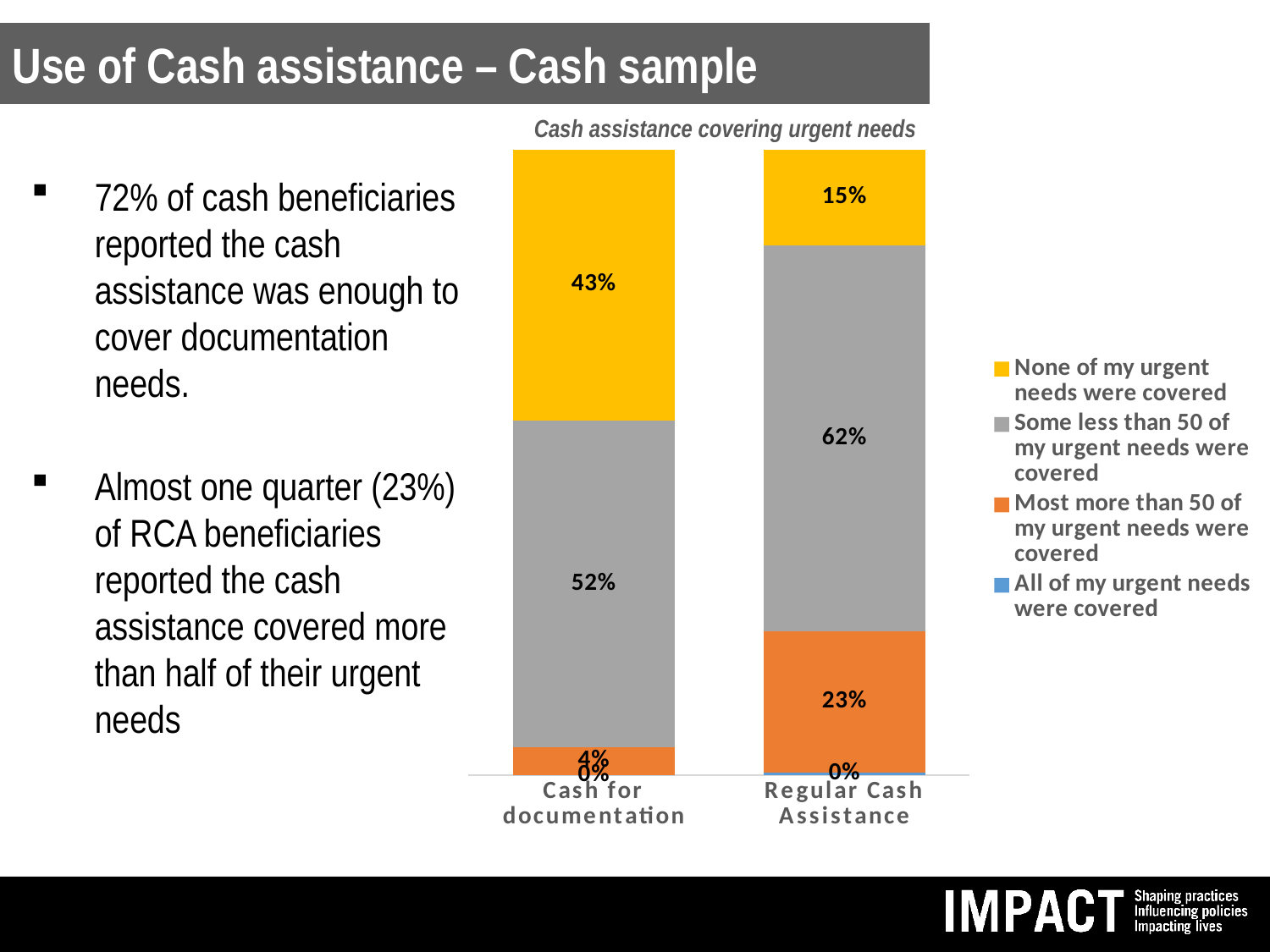
What percentage of Cash for documentation beneficiaries reported that none of their urgent needs were covered? 43% Which category has the larger share for 'None of my urgent needs were covered', Cash for documentation or Regular Cash Assistance? Cash for documentation How many categories are shown on the x axis? 2 What is the title of the chart? Cash assistance covering urgent needs What is the difference between the 'Some less than 50 of my urgent needs were covered' shares for Regular Cash Assistance and Cash for documentation? 10% Which colour represents 'Most more than 50 of my urgent needs were covered' in the chart? Orange What percentage of Regular Cash Assistance beneficiaries reported that some (less than 50) of their urgent needs were covered? 62% What percentage of Regular Cash Assistance beneficiaries reported that all of their urgent needs were covered? 0% How many series does the legend list? 4 What kind of chart is shown on the slide? Stacked bar chart What percentage of Regular Cash Assistance beneficiaries reported that most (more than 50) of their urgent needs were covered? 23% What percentage of Cash for documentation beneficiaries reported that most (more than 50) of their urgent needs were covered? 4%